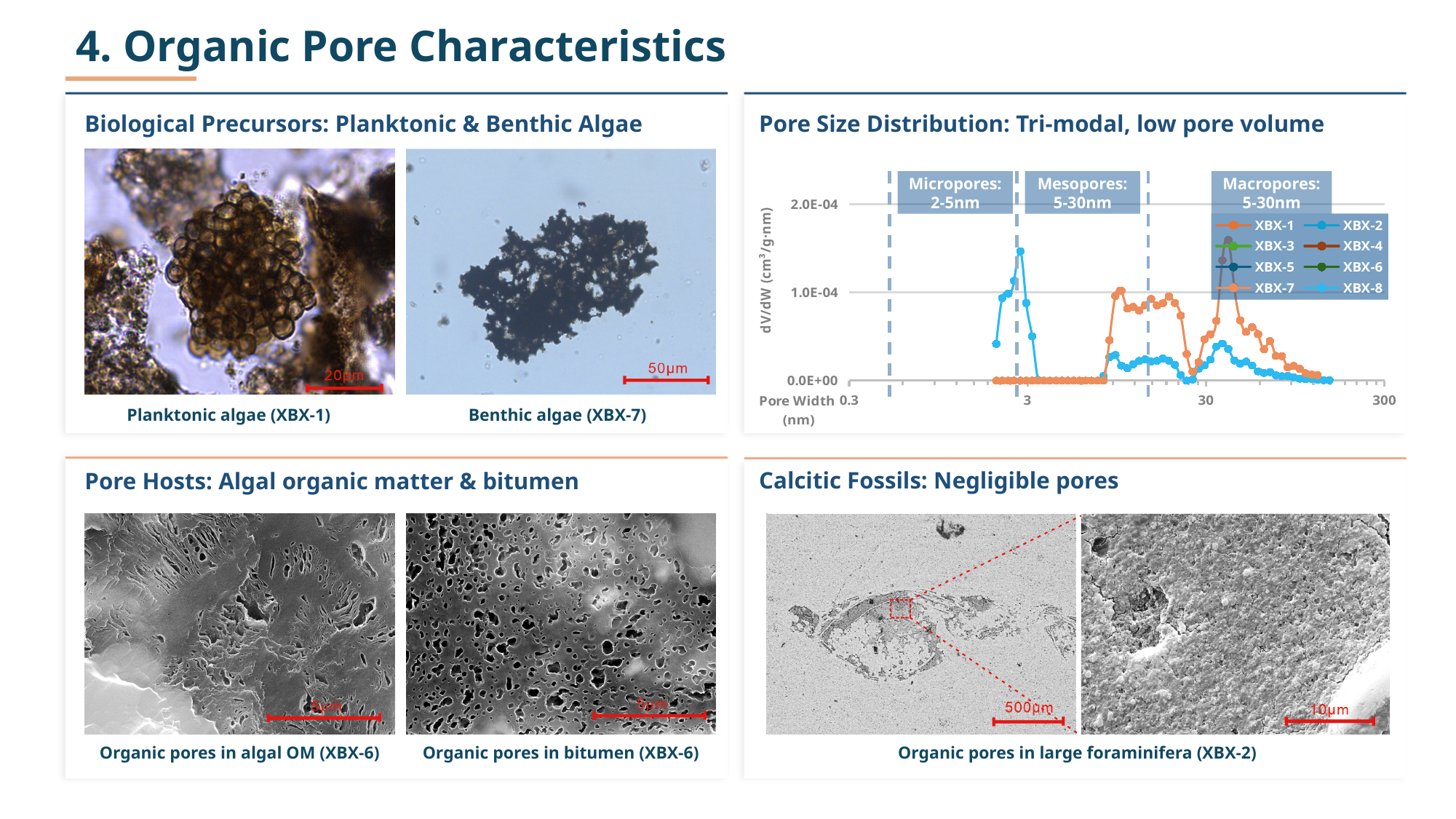
How many series does the legend of the Pore Size Distribution chart list? 8 In the Pore Size Distribution chart, does the tallest peak occur near a pore width of 3 nm or near 30 nm? near 3 nm What is the title of the chart on the slide? Pore Size Distribution: Tri-modal, low pore volume What is the largest pore width value labelled on the x-axis of the Pore Size Distribution chart? 300 What kind of chart is shown under 'Pore Size Distribution: Tri-modal, low pore volume'? line chart How many tick labels are shown on the x-axis of the Pore Size Distribution chart? 4 In the Pore Size Distribution chart, is the highest peak on the chart greater or less than 1.0E-04? greater What is the y-axis label of the Pore Size Distribution chart? dV/dW (cm³/g·nm) What is the highest tick value shown on the y-axis of the Pore Size Distribution chart? 2.0E-04